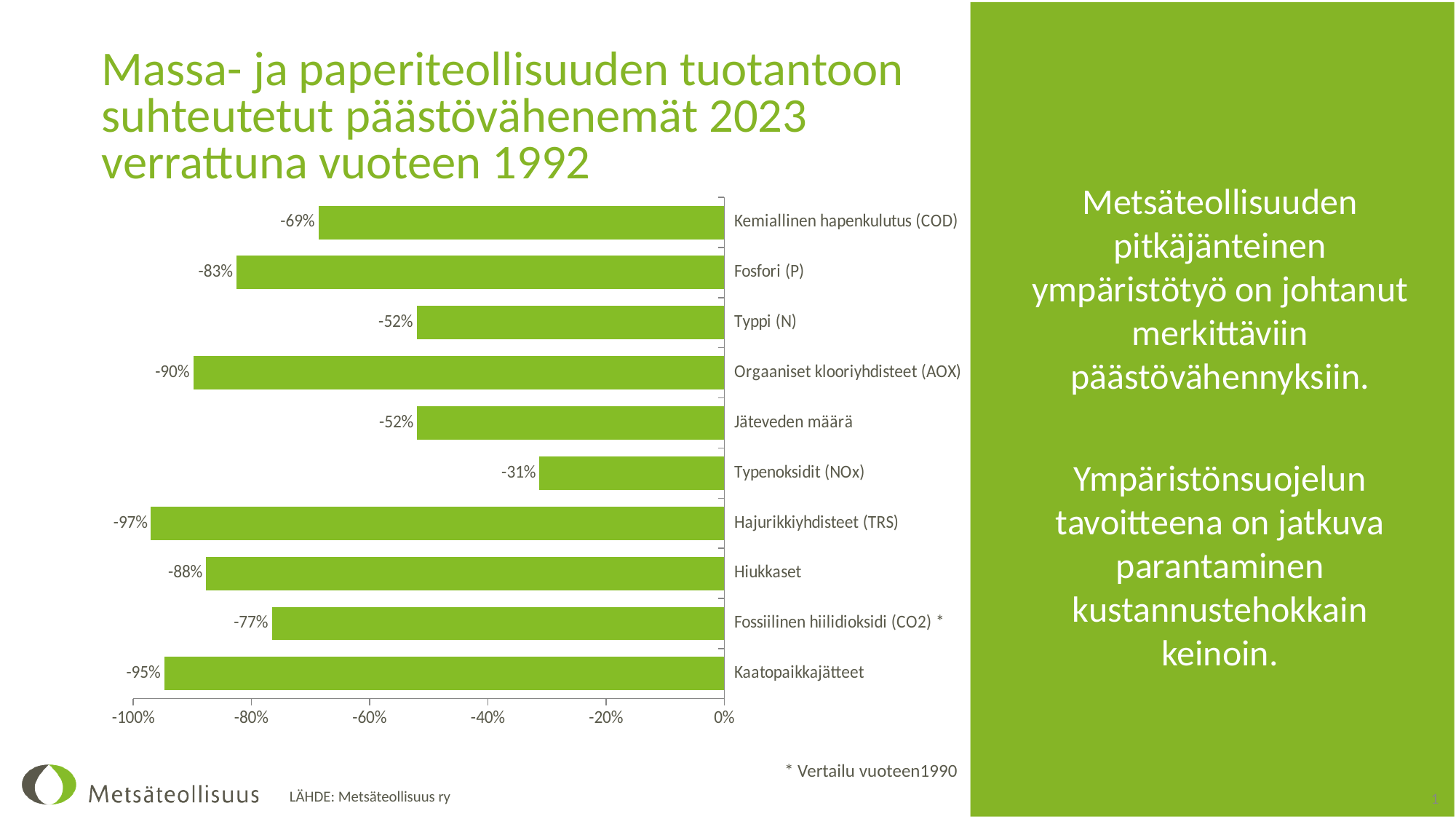
By how many percentage points does the reduction for Hajurikkiyhdisteet (TRS) exceed that for Kaatopaikkajätteet? 2 percentage points What is the value shown for Fossiilinen hiilidioksidi (CO2)? -77% According to the footnote, which year is the comparison year for the category marked with an asterisk? 1990 What is the value shown for Orgaaniset klooriyhdisteet (AOX)? -90% Which shows a larger reduction, Fosfori (P) or Hiukkaset? Hiukkaset What kind of chart is shown on the slide? Bar chart Which two categories both show a value of -52%? Typpi (N) and Jäteveden määrä Which category shows the largest reduction (the most negative value)? Hajurikkiyhdisteet (TRS) How many categories are plotted in the chart? 10 What is the value shown for Kaatopaikkajätteet? -95% What is the value shown for Kemiallinen hapenkulutus (COD)? -69% Which category shows the smallest reduction (the value closest to 0%)? Typenoksidit (NOx)